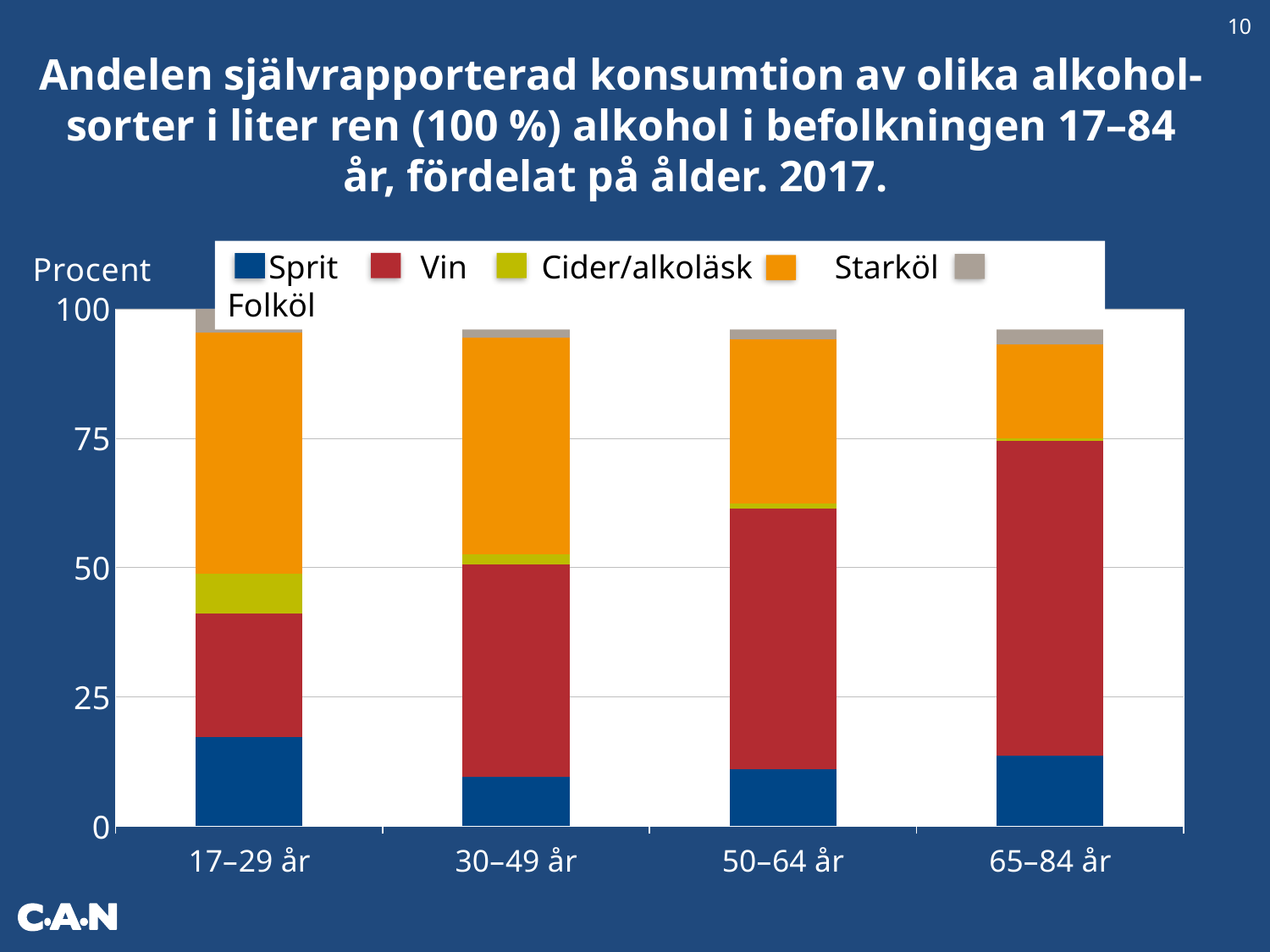
Is the Vin share larger for 17–29 år or for 65–84 år? 65–84 år Which series is shown in orange in the legend? Starköl Is the Vin share for 65–84 år greater or less than 50? greater Is the Sprit share for 17–29 år greater or less than 25? less Does the Vin share rise or fall as age increases along the x axis? rise How many age groups are shown on the x axis? 4 Is the Starköl share for 65–84 år greater or less than 25? less How many series does the legend list? 5 Which age group has the largest Starköl share? 17–29 år Which age group has the largest Cider/alkoläsk share? 17–29 år What kind of chart is shown on the slide? stacked bar chart What is the label of the y axis? Procent